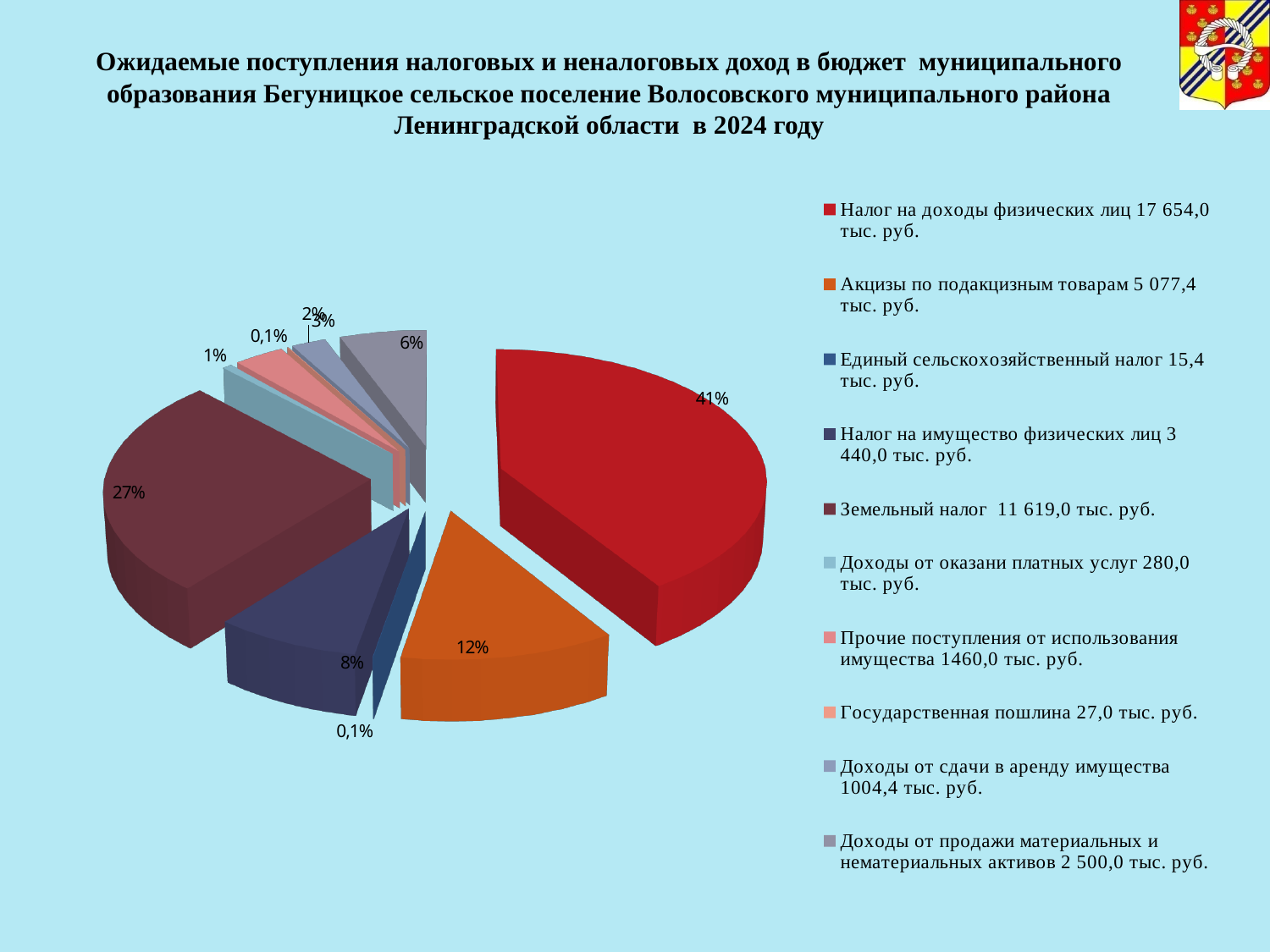
According to the legend, what is the expected amount for "Земельный налог"? 11 619,0 тыс. руб. Which slice is larger: "Земельный налог" or "Акцизы по подакцизным товарам"? Земельный налог By how many percentage points does the share of "Налог на доходы физических лиц" exceed the share of "Земельный налог"? 14 percentage points Which category has the largest slice of the pie? Налог на доходы физических лиц What kind of chart is shown on the slide? Pie chart According to the legend, what is the expected amount for "Государственная пошлина"? 27,0 тыс. руб. What share of the pie does "Акцизы по подакцизным товарам" account for? 12% How many categories does the legend of the pie chart list? 10 What share of the pie does "Налог на имущество физических лиц" account for? 8% What share of the pie does "Земельный налог" account for? 27% What colour is the slice for "Акцизы по подакцизным товарам"? Orange What share of the pie does "Налог на доходы физических лиц" account for? 41%